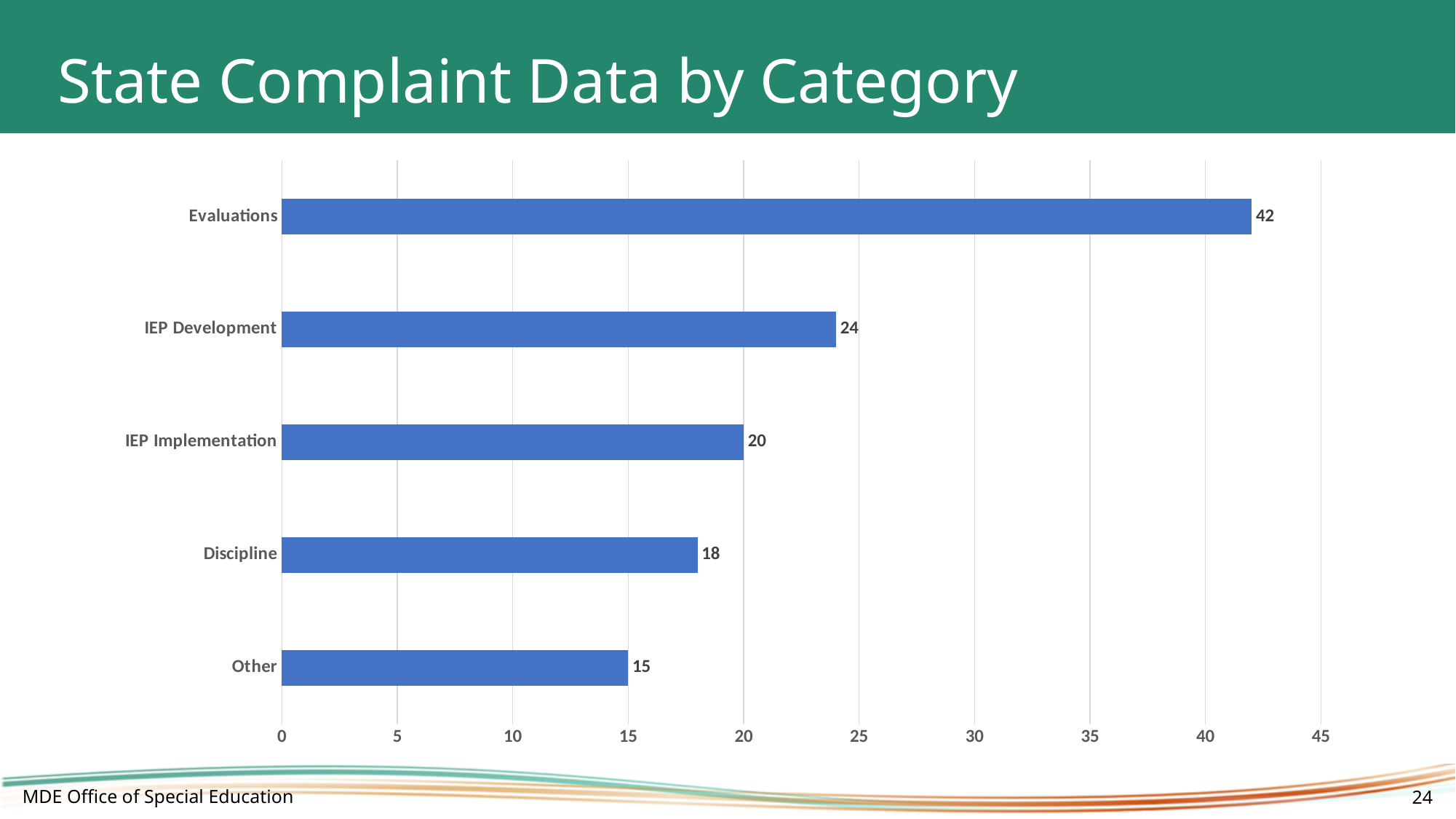
What is the value for Evaluations? 42 What is the difference between the values for IEP Implementation and Other? 5 How many categories are shown in the chart? 5 Which category has the highest value? Evaluations What is the value for Other? 15 What is the value for IEP Development? 24 What is the difference between the values for Evaluations and IEP Development? 18 Which category has the lowest value? Other What kind of chart is shown on the slide? Bar chart Which is larger, the value for IEP Implementation or the value for Discipline? IEP Implementation What is the value for Discipline? 18 What is the title of the slide containing the chart? State Complaint Data by Category